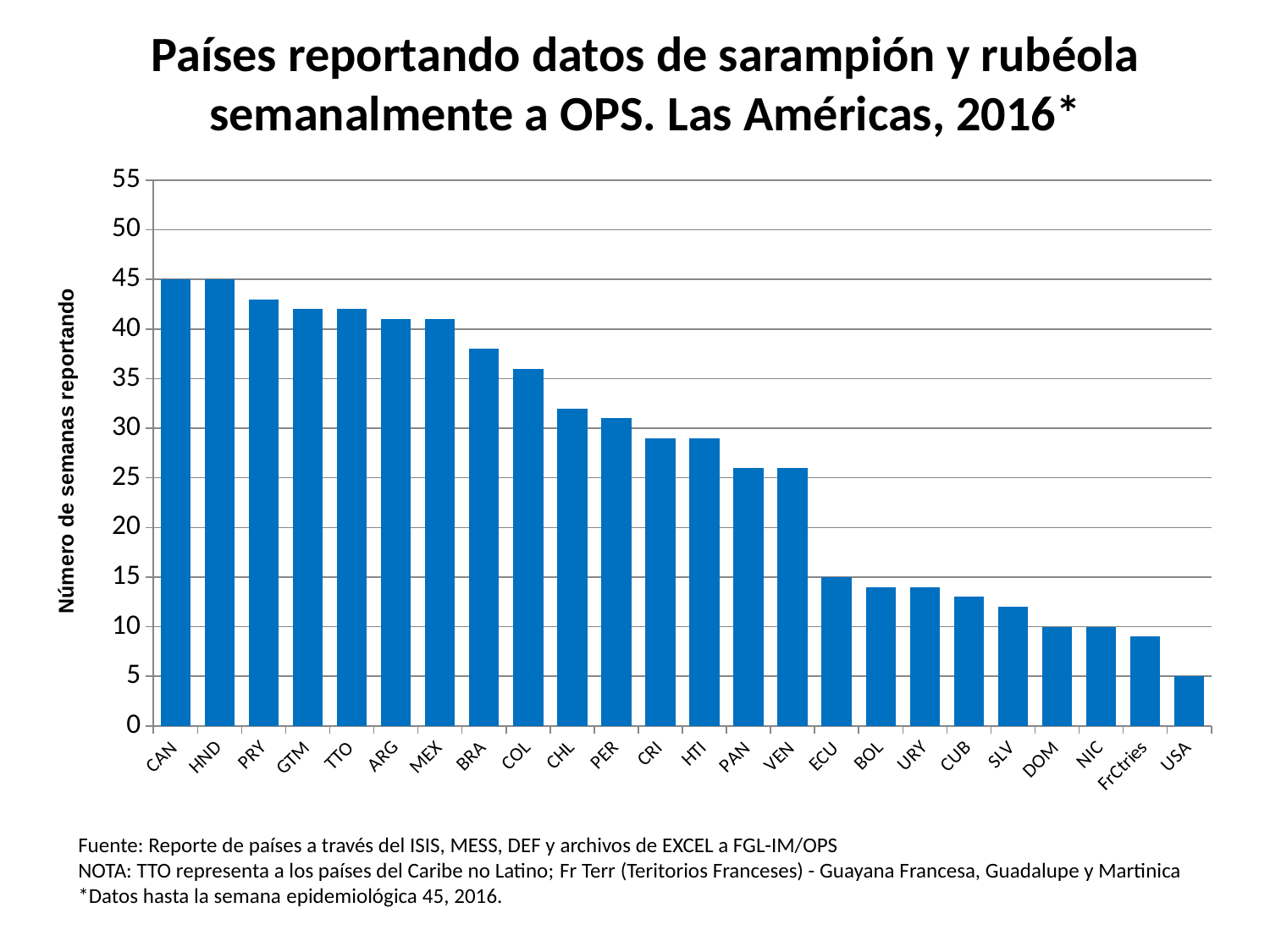
How many weeks did ECU report? 15 What kind of chart is shown on the slide? bar chart Which reported more weeks, BRA or ECU? BRA How many countries or groups are shown on the x axis? 24 How many weeks did CAN report? 45 How many weeks did USA report? 5 Do the values rise or fall moving from left to right along the x axis? fall What is the difference between the number of weeks reported by CAN and by USA? 40 Is the value for BRA greater or less than 40? less Is the value for PRY greater or less than 40? greater Which country has the lowest number of weeks reported? USA Is the value for CHL greater or less than 30? greater